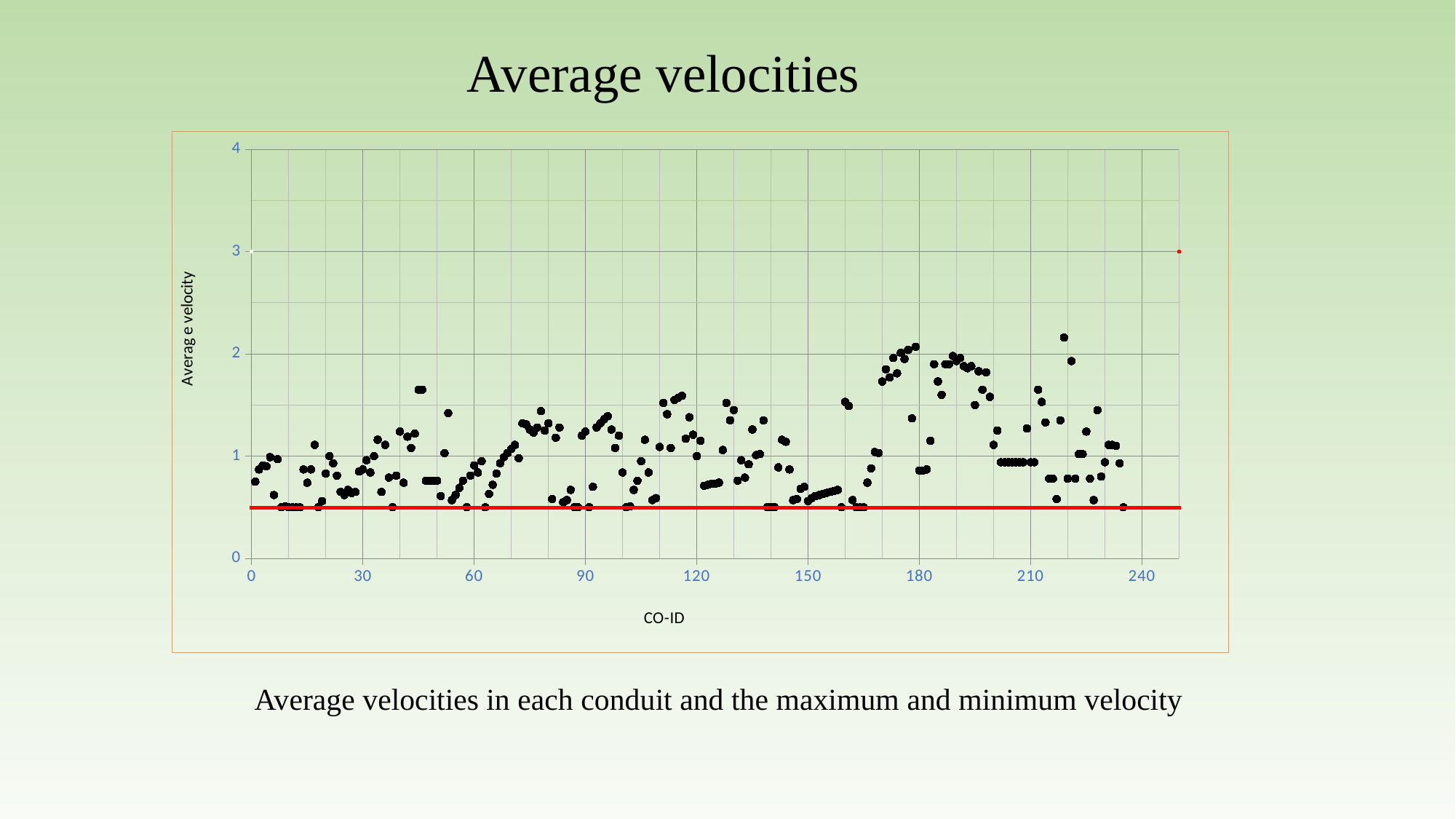
What is the title of the chart? Average velocities Is the highest black data point on the chart greater or less than 2? greater What is the highest value shown on the y axis? 4 Are all the black data points greater or less than 3? less Is the red horizontal line (minimum velocity) greater or less than 1? less What kind of chart is shown on the slide? scatter chart What is the label of the x axis? CO-ID